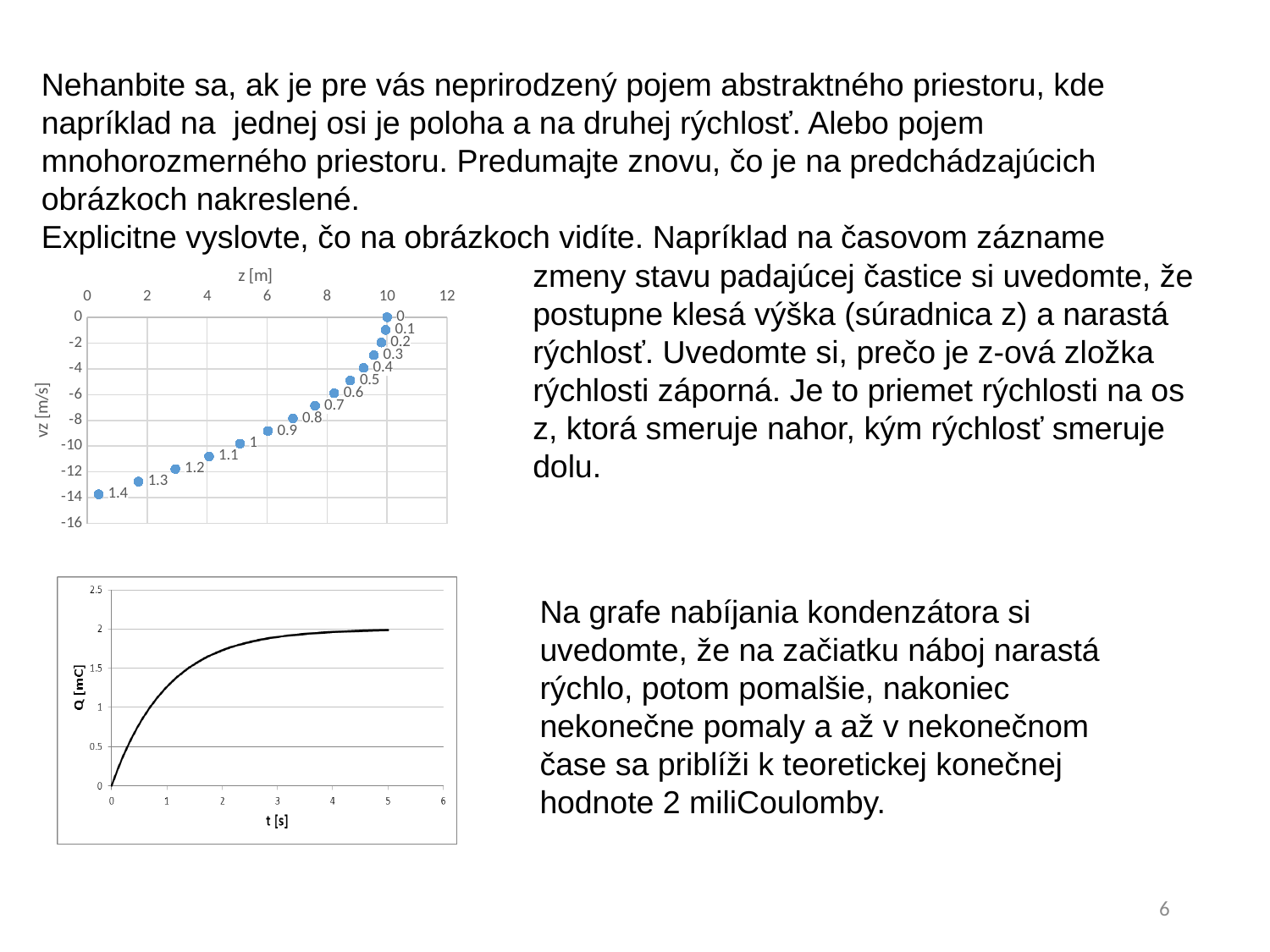
How many data points are plotted in the top chart (vz versus z)? 15 What kind of chart is the top chart (vz versus z)? scatter chart In the top chart (vz versus z), which data label marks the point with the lowest vz value? 1.4 What is the label of the vertical axis of the top chart? vz [m/s] In the bottom chart (Q versus t), does Q rise or fall as t increases? rise In the bottom chart (Q versus t), is the value of Q at t = 5 greater or less than 1.5? greater What is the label of the horizontal axis of the bottom chart? t [s] What kind of chart is the bottom chart (Q versus t)? line chart In the top chart (vz versus z), do the vz values rise or fall as z increases? rise In the top chart (vz versus z), is the vz value of the point labelled 1.4 greater or less than -12? less In the top chart (vz versus z), which data label marks the point with the highest vz value? 0 In the top chart (vz versus z), is the vz value of the point labelled 0.3 greater or less than -4? greater